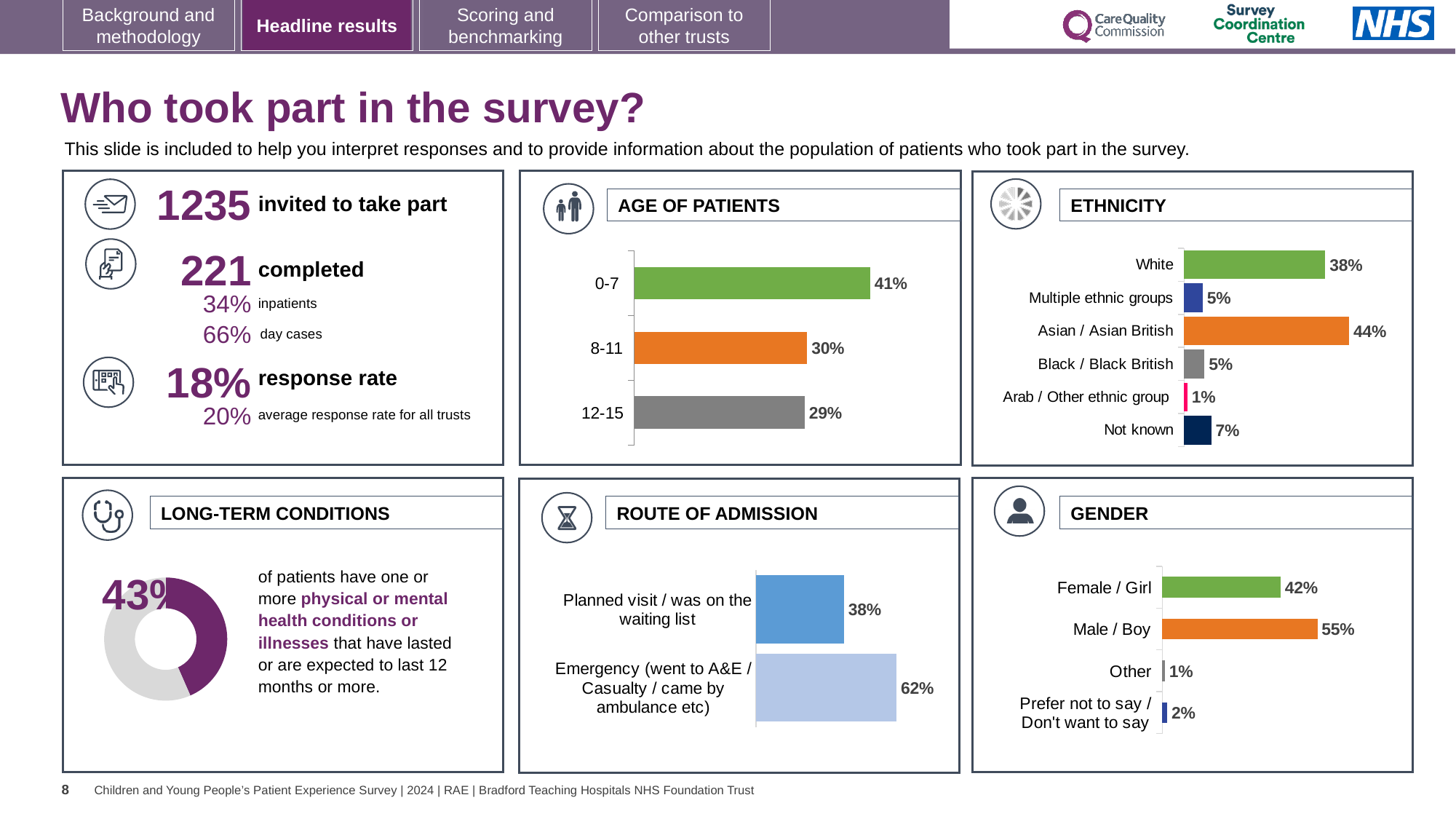
In the GENDER chart, what percentage of patients were Male / Boy? 55% How many categories are shown in the ETHNICITY chart? 6 In the AGE OF PATIENTS chart, which age group has the lowest percentage? 12-15 In the ETHNICITY chart, what is the difference between the White and Asian / Asian British percentages? 6% In the ETHNICITY chart, what is the percentage for Not known? 7% In the LONG-TERM CONDITIONS chart, what percentage of patients have one or more long-term conditions? 43% What kind of chart is used in the LONG-TERM CONDITIONS panel? Doughnut chart In the ETHNICITY chart, which category has the highest percentage? Asian / Asian British In the GENDER chart, what is the difference between Male / Boy and Female / Girl? 13% In the AGE OF PATIENTS chart, what percentage of patients were aged 0-7? 41% In the ROUTE OF ADMISSION chart, which is larger: Planned visit / was on the waiting list or Emergency? Emergency (went to A&E / Casualty / came by ambulance etc) In the ROUTE OF ADMISSION chart, what percentage of patients came via Emergency (went to A&E / Casualty / came by ambulance etc)? 62%